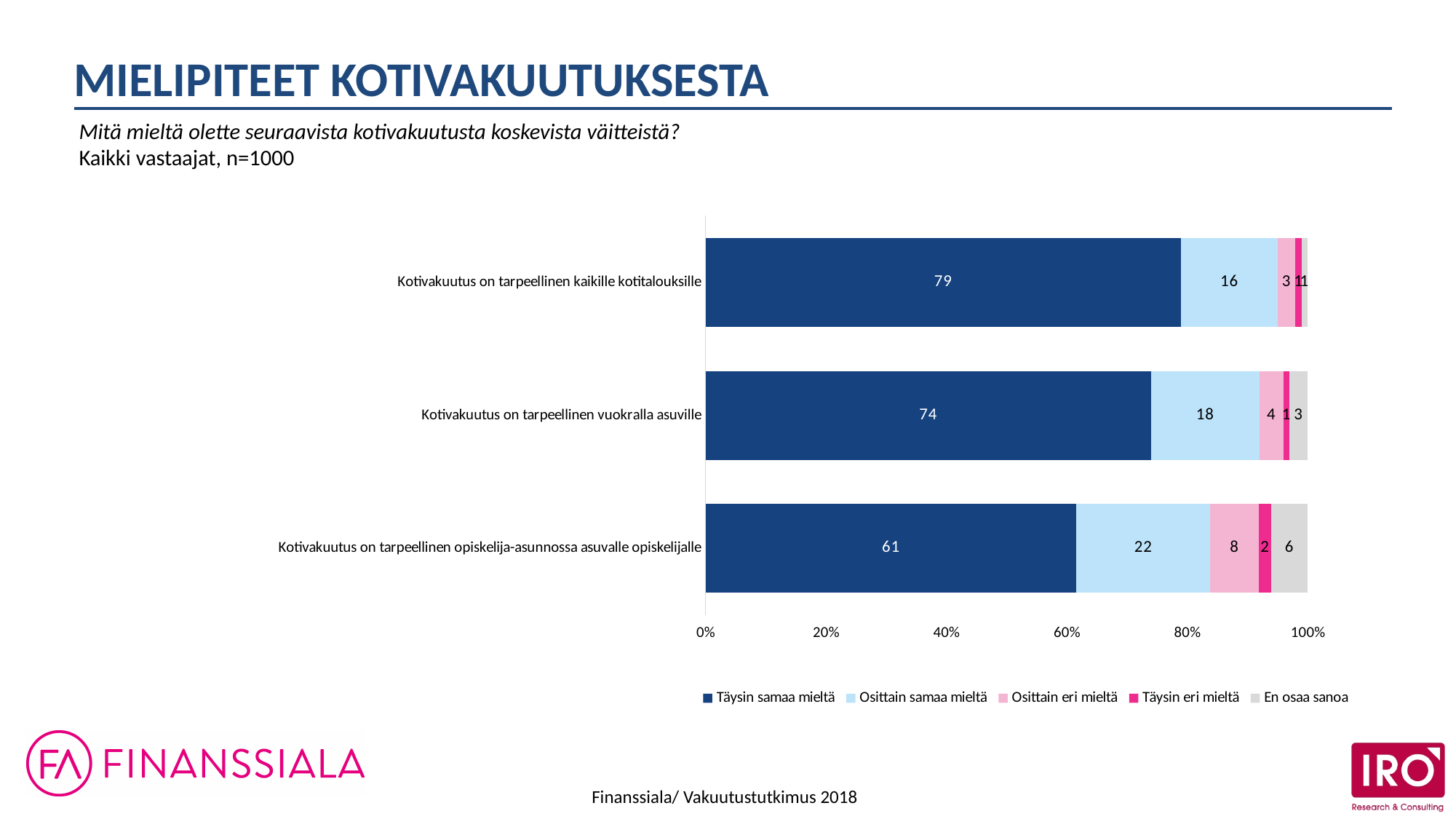
What is the 'En osaa sanoa' value for 'Kotivakuutus on tarpeellinen opiskelija-asunnossa asuvalle opiskelijalle'? 6 Which legend entry is shown in dark blue? Täysin samaa mieltä Which statement has the highest 'Täysin samaa mieltä' value? Kotivakuutus on tarpeellinen kaikille kotitalouksille How many statements (categories) are plotted in the chart? 3 What is the difference between the 'Täysin samaa mieltä' values for 'Kotivakuutus on tarpeellinen kaikille kotitalouksille' and 'Kotivakuutus on tarpeellinen vuokralla asuville'? 5 What is the 'Osittain eri mieltä' value for 'Kotivakuutus on tarpeellinen opiskelija-asunnossa asuvalle opiskelijalle'? 8 What kind of chart is shown on the slide? stacked bar chart What is the 'Osittain samaa mieltä' value for 'Kotivakuutus on tarpeellinen vuokralla asuville'? 18 Which is larger: the 'Osittain samaa mieltä' value for 'Kotivakuutus on tarpeellinen vuokralla asuville' or for 'Kotivakuutus on tarpeellinen opiskelija-asunnossa asuvalle opiskelijalle'? Kotivakuutus on tarpeellinen opiskelija-asunnossa asuvalle opiskelijalle Which statement has the lowest 'Täysin samaa mieltä' value? Kotivakuutus on tarpeellinen opiskelija-asunnossa asuvalle opiskelijalle What is the 'Täysin samaa mieltä' value for 'Kotivakuutus on tarpeellinen kaikille kotitalouksille'? 79 How many series does the legend list? 5